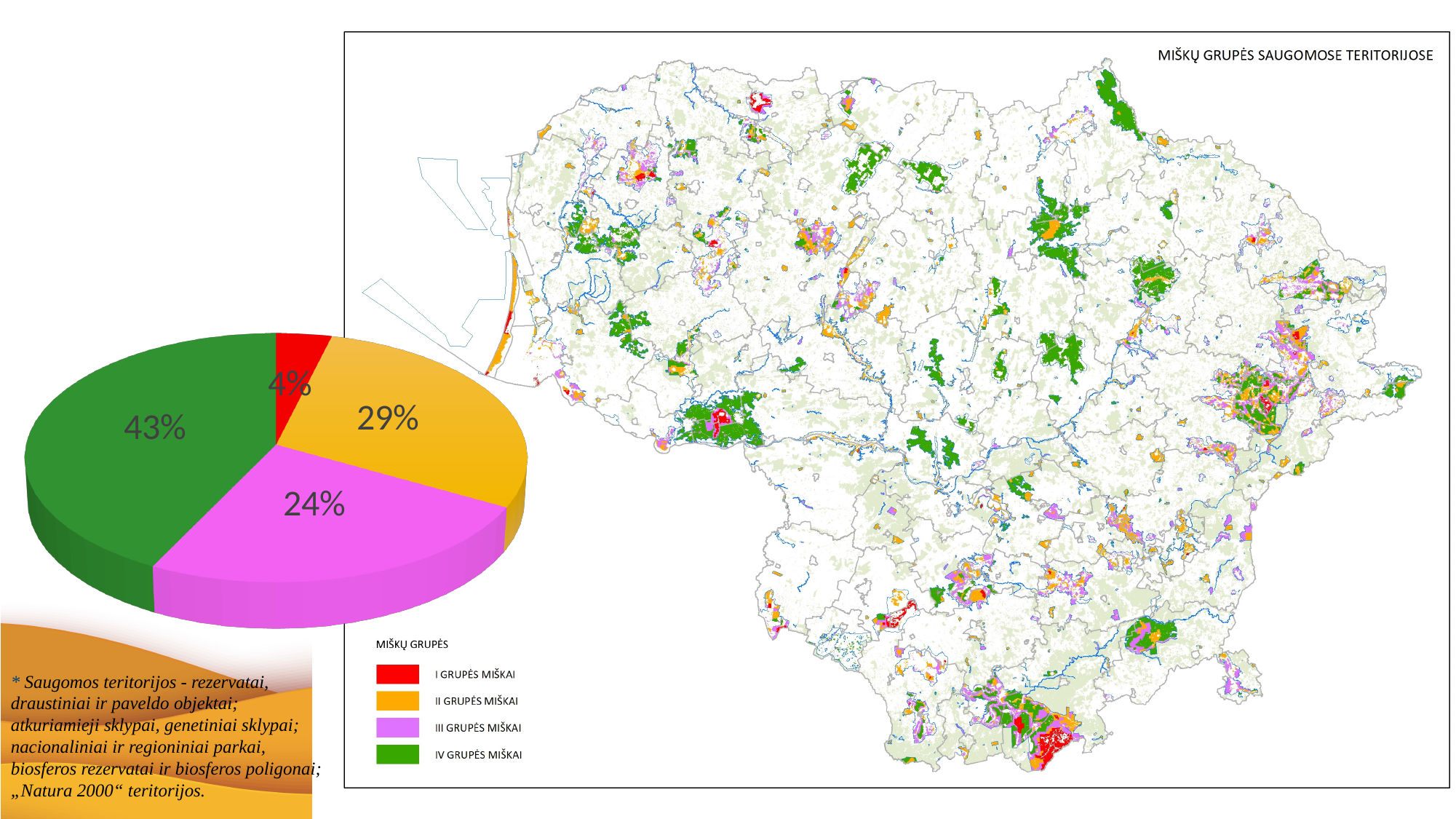
What kind of chart is shown on the left side of the slide? pie chart Which slice of the pie chart is the smallest? red (4%) How many forest groups does the map legend (MIŠKŲ GRUPĖS) list? 4 What percentage is shown on the green slice of the pie chart? 43% What is the title of the map on the right side of the slide? MIŠKŲ GRUPĖS SAUGOMOSE TERITORIJOSE What percentage is shown on the pink slice of the pie chart? 24% What is the difference between the green slice and the orange slice of the pie chart? 14 percentage points What percentage is shown on the red slice of the pie chart? 4% Which slice of the pie chart is the largest? green (43%) How many slices does the pie chart have? 4 What percentage is shown on the orange slice of the pie chart? 29% Which is larger in the pie chart, the orange slice or the pink slice? orange